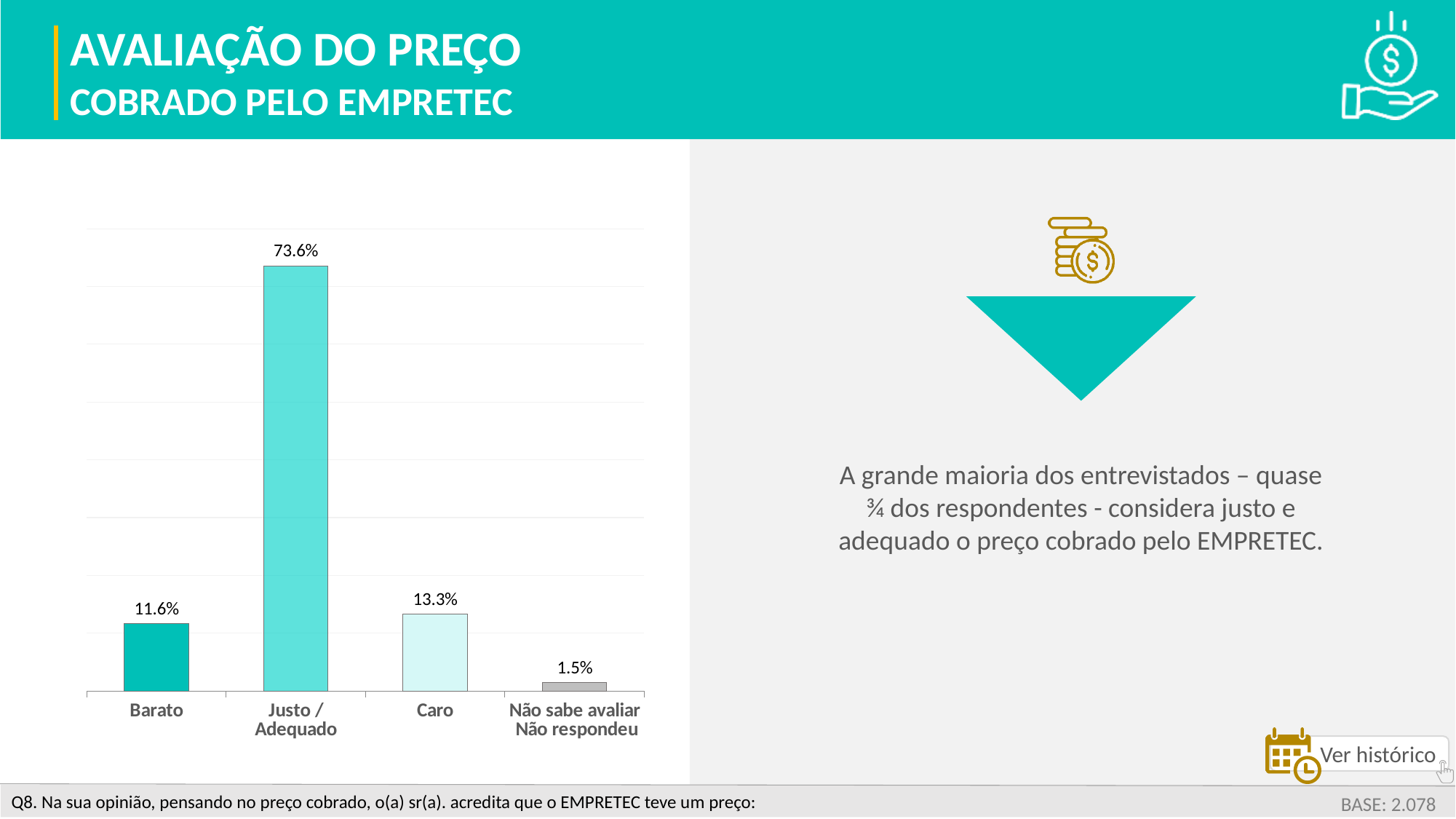
Which is larger, the value for Caro or the value for Barato? Caro Which category has the lowest value? Não sabe avaliar / Não respondeu What is the value for Caro? 13.3% What is the difference between the values for Caro and Barato? 1.7% What kind of chart is shown on the slide? Bar chart What is the difference between the values for Justo / Adequado and Caro? 60.3% What is the value for Justo / Adequado? 73.6% What is the base (number of respondents) shown on the slide? 2.078 What is the value for Não sabe avaliar / Não respondeu? 1.5% Which category has the highest value? Justo / Adequado What is the value for Barato? 11.6% How many categories are shown in the chart? 4